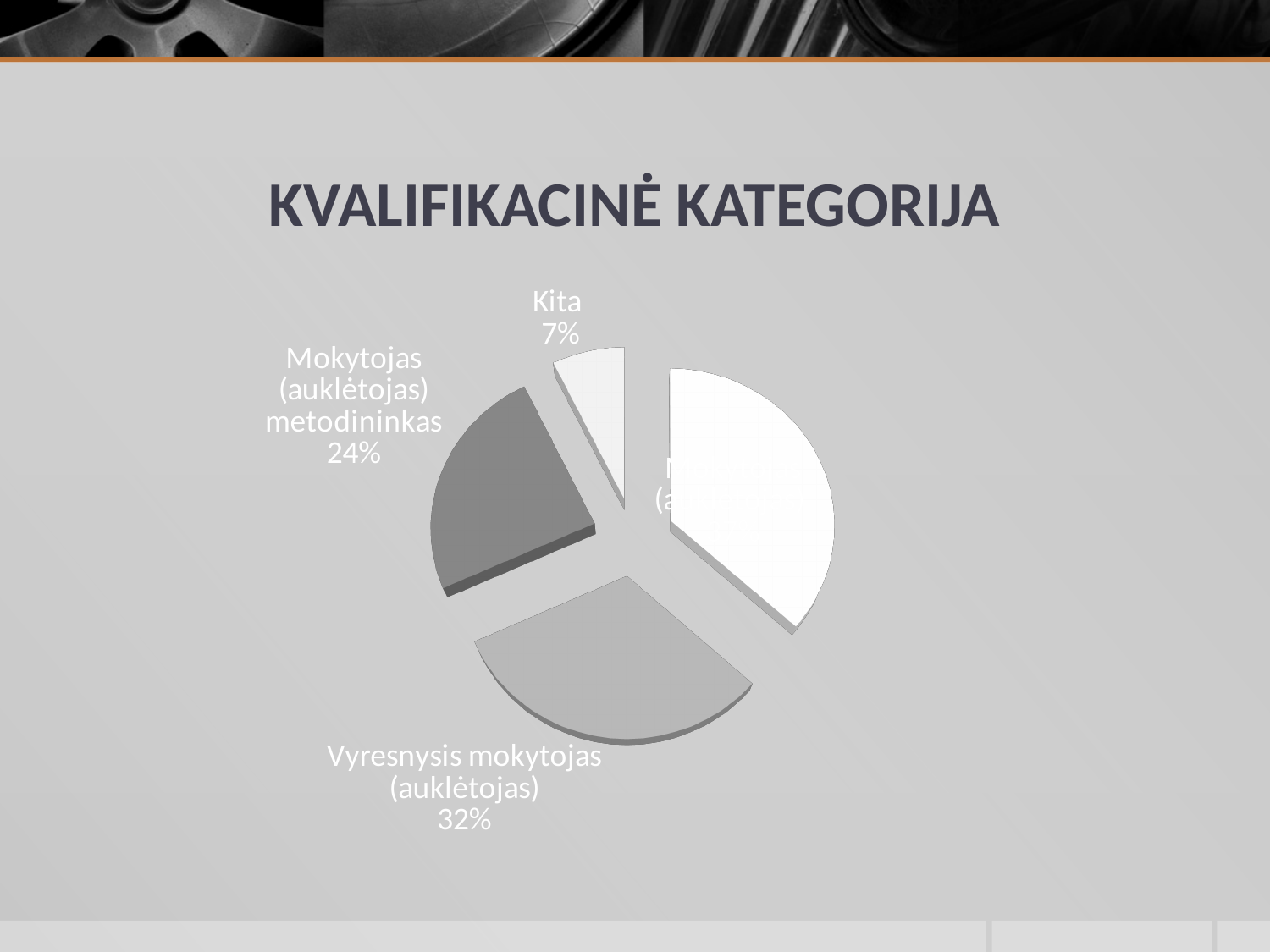
What percentage is shown for Vyresnysis mokytojas (auklėtojas)? 32% Which is larger: Kita or Mokytojas (auklėtojas) metodininkas? Mokytojas (auklėtojas) metodininkas What is the title of the chart? KVALIFIKACINĖ KATEGORIJA What percentage is shown for Mokytojas (auklėtojas) metodininkas? 24% What is the difference in percentage points between Vyresnysis mokytojas (auklėtojas) and Mokytojas (auklėtojas) metodininkas? 8 percentage points How many slices does the pie chart have? 4 What is the difference in percentage points between Mokytojas (auklėtojas) metodininkas and Kita? 17 percentage points What share of the pie does Kita represent? 7% What kind of chart is shown on the slide? pie chart Which is larger: Vyresnysis mokytojas (auklėtojas) or Mokytojas (auklėtojas) metodininkas? Vyresnysis mokytojas (auklėtojas) Which category has the smallest slice of the pie? Kita